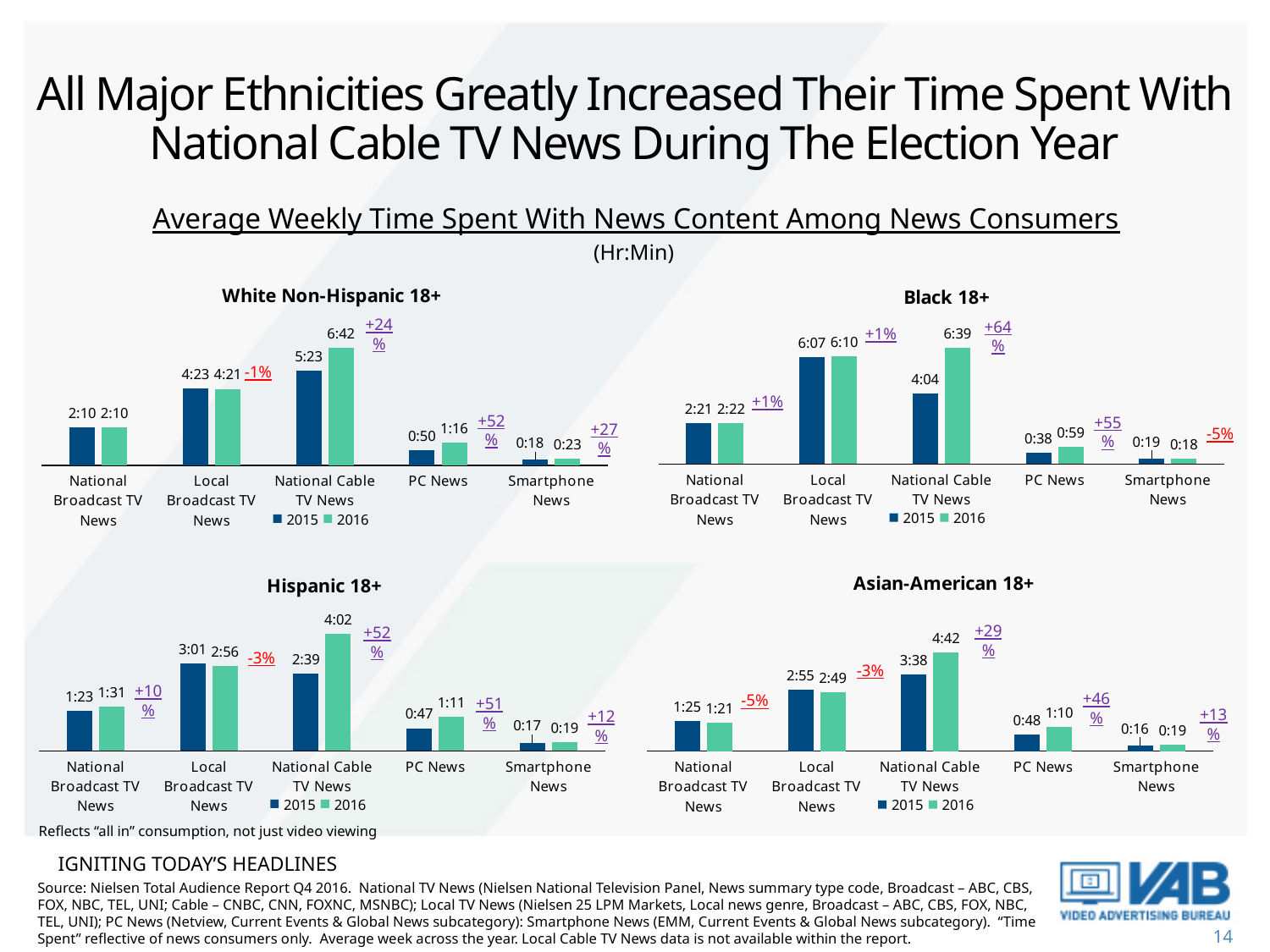
In the Black 18+ chart, which category has the highest 2016 value? National Cable TV News In the Asian-American 18+ chart, what is the 2015 value for PC News? 0:48 In the Hispanic 18+ chart, which is larger for National Broadcast TV News, the 2015 value or the 2016 value? 2016 What kind of chart is the Black 18+ chart? Bar chart In the White Non-Hispanic 18+ chart, what is the 2016 value for National Cable TV News? 6:42 In the White Non-Hispanic 18+ chart, which category has the lowest 2015 value? Smartphone News In the Black 18+ chart, what percentage change is labeled for National Cable TV News? +64% In the Hispanic 18+ chart, what is the 2016 value for National Cable TV News? 4:02 In the White Non-Hispanic 18+ chart, what is the difference between the 2016 and 2015 values for PC News? 0:26 In the Asian-American 18+ chart, how many series does the legend list? 2 In the Black 18+ chart, what is the 2015 value for Local Broadcast TV News? 6:07 In the Hispanic 18+ chart, how many categories are shown on the x axis? 5